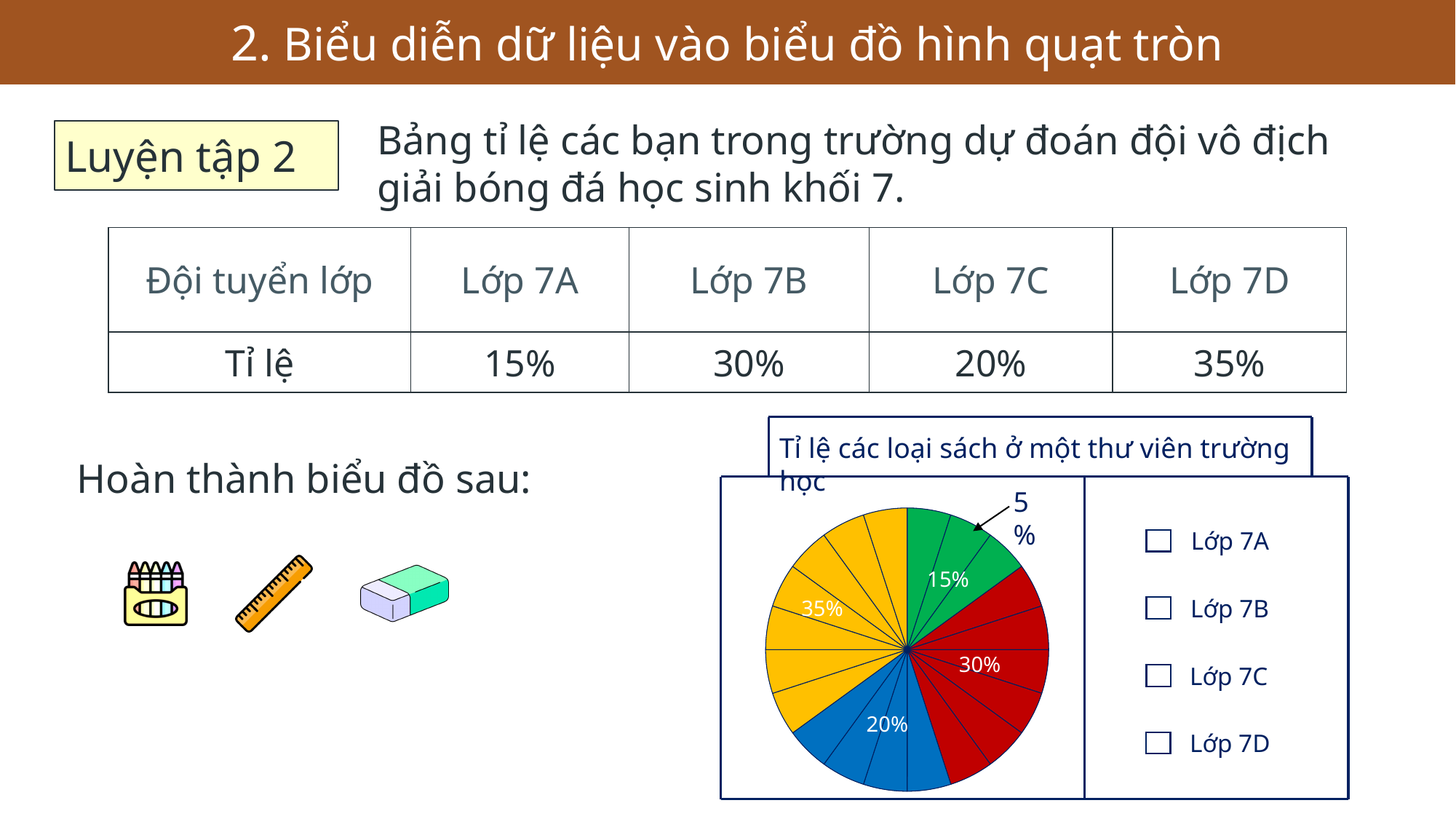
What is the difference between the largest slice (35%) and the smallest coloured slice (15%) of the pie chart? 20% What is the smallest percentage labelled on a coloured slice of the pie chart? 15% Which is larger on the pie chart, the red slice or the blue slice? the red slice (30%) What percentage is labelled on the blue slice of the pie chart? 20% What is the title written above the pie chart? Tỉ lệ các loại sách ở một thư viện trường học What is the largest percentage labelled on the pie chart? 35% How many entries does the legend of the pie chart list? 4 What percentage is labelled on the yellow slice of the pie chart? 35% What colour is the slice labelled 30% on the pie chart? red What percentage does the arrow on the pie chart point to for one small sector? 5% What kind of chart is shown on the slide? pie chart